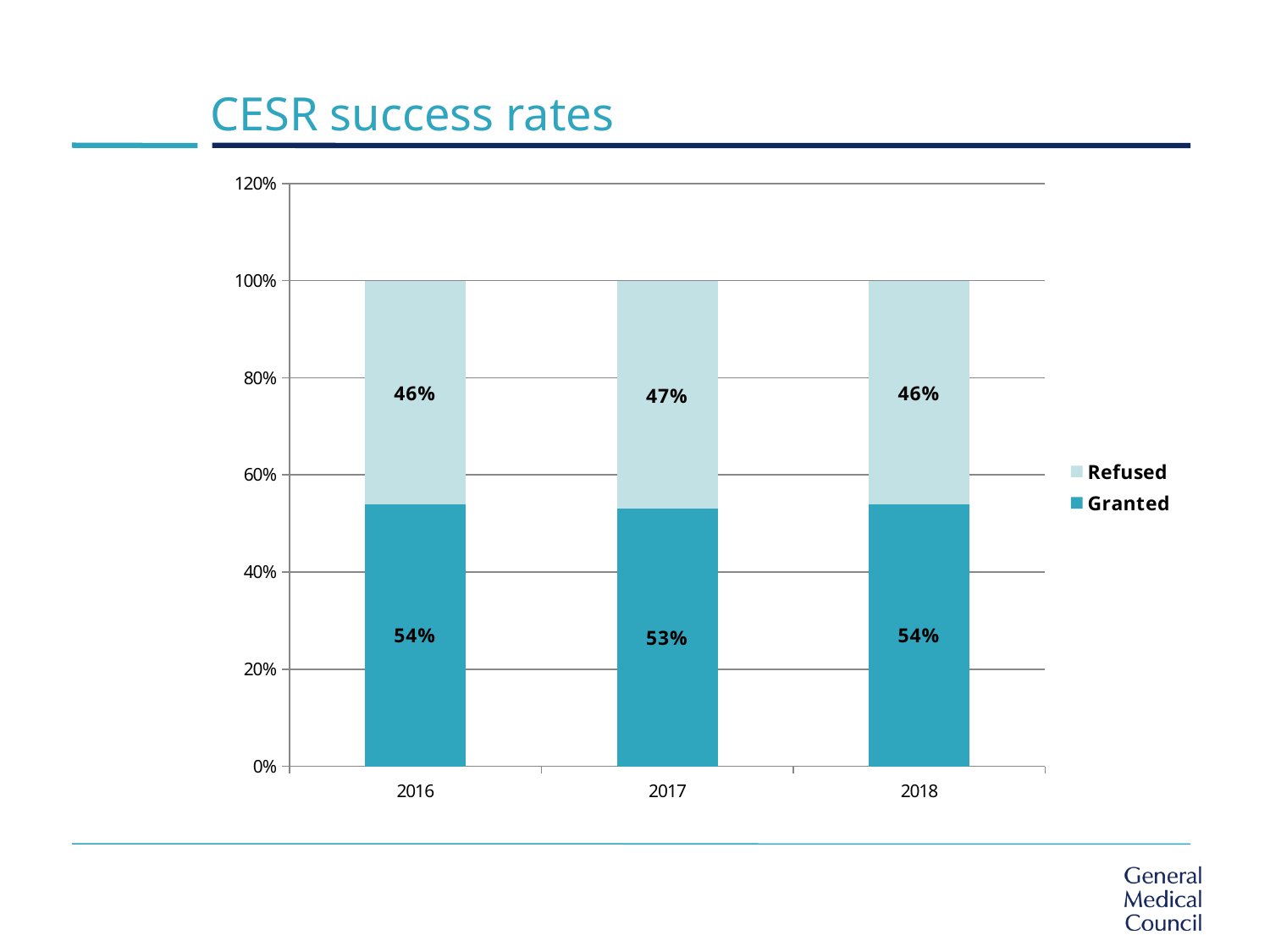
In which year is the Refused value highest? 2017 What is the Granted value for 2016? 54% What is the total of the stacked bar for 2016? 100% What is the Granted value for 2018? 54% What is the difference between the Granted and Refused values in 2017? 6% In which year is the Granted value lowest? 2017 What is the Refused value for 2017? 47% What kind of chart is shown on the slide? Stacked bar chart How many series does the legend list? 2 In 2018, which is larger, Granted or Refused? Granted How many years are shown on the x axis? 3 What is the Refused value for 2016? 46%